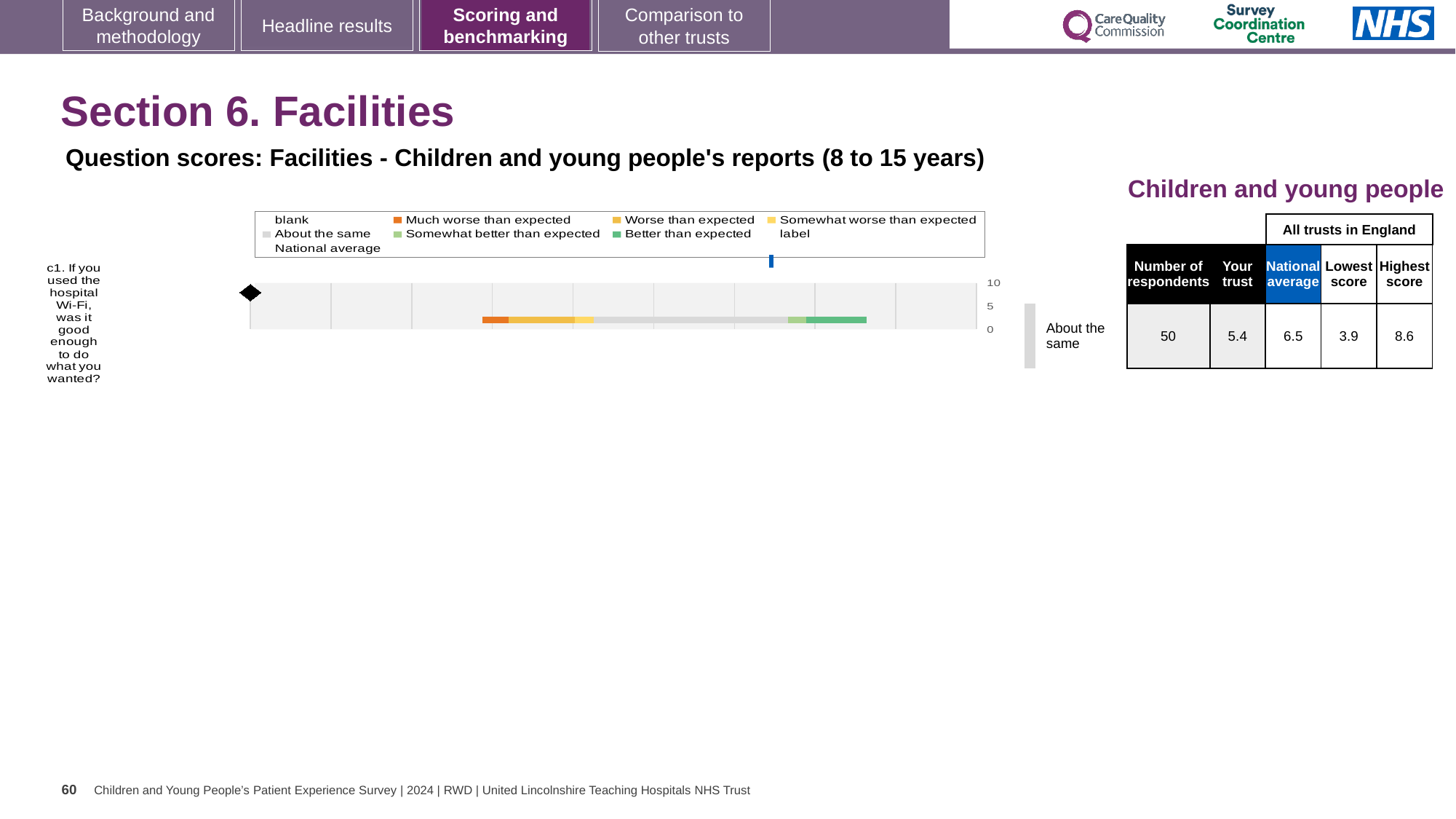
In the table, what is the highest score among all trusts in England for question c1? 8.6 In the table, what is the 'Your trust' score for question c1 about hospital Wi-Fi? 5.4 In the table, what is the lowest score among all trusts in England for question c1? 3.9 How many entries does the chart legend list? 9 How many survey questions are plotted in the chart? 1 In the table, what is the national average score for question c1? 6.5 What kind of chart is shown on the slide? bar chart Which legend entry is shown in orange? Much worse than expected Which is larger for question c1: the 'Your trust' score or the national average? National average What is the difference between the highest score and the lowest score for question c1 in the table? 4.7 Which legend entry is shown in dark green? Better than expected How many respondents answered question c1 according to the table? 50